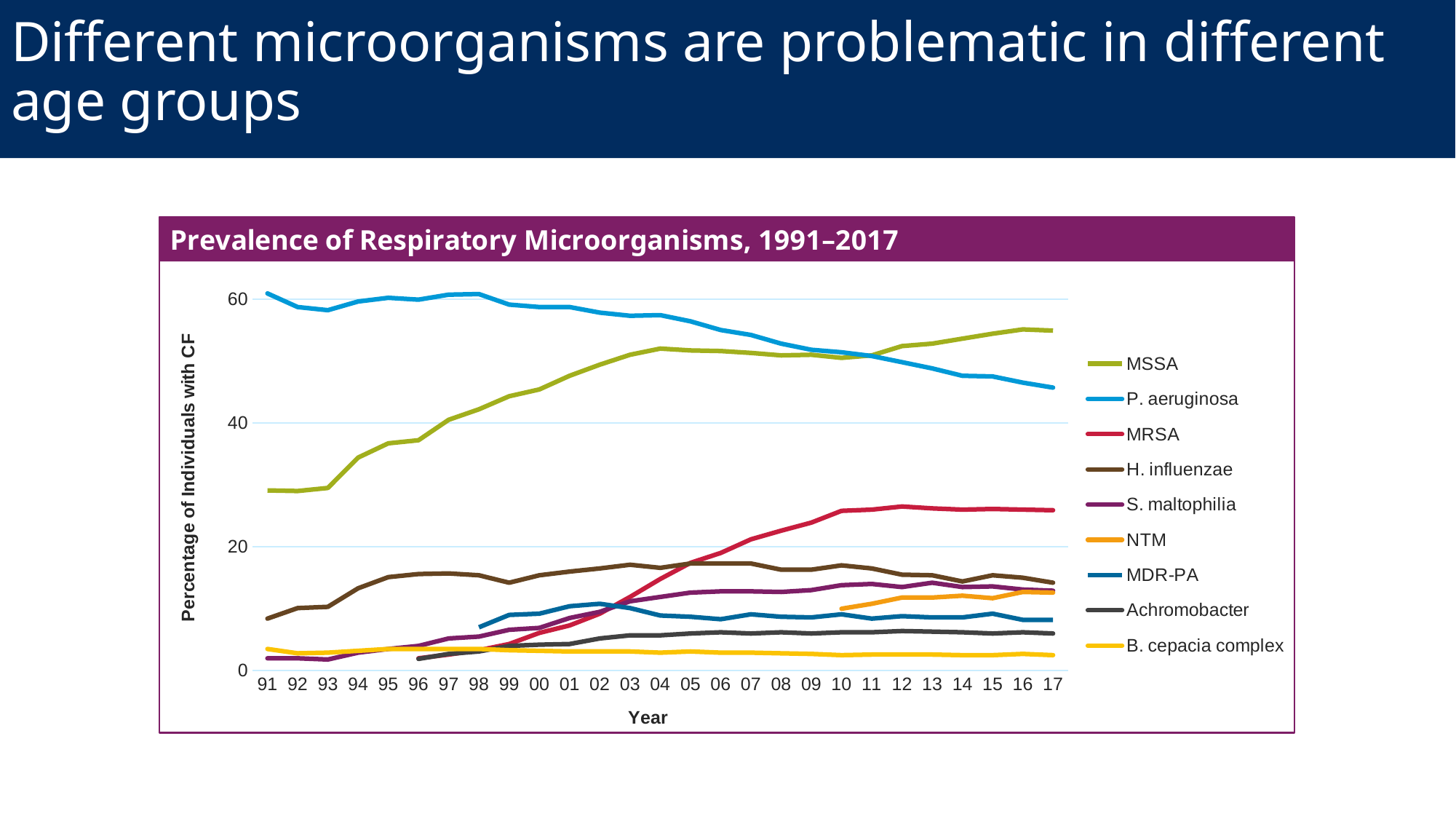
Is the value for MRSA in 17 greater or less than 20? greater How many years are shown along the x axis? 27 Which series has the highest value in 91? P. aeruginosa Which series has the lowest value in 17? B. cepacia complex How many series does the legend list? 9 Is the value for MSSA in 91 greater or less than 40? less What is the title of the chart? Prevalence of Respiratory Microorganisms, 1991–2017 In 17, which is larger, MSSA or P. aeruginosa? MSSA Does the P. aeruginosa line rise or fall from 91 to 17? fall Does the MSSA line rise or fall from 91 to 17? rise Is the value for P. aeruginosa in 17 greater or less than 40? greater What kind of chart is shown on the slide? line chart